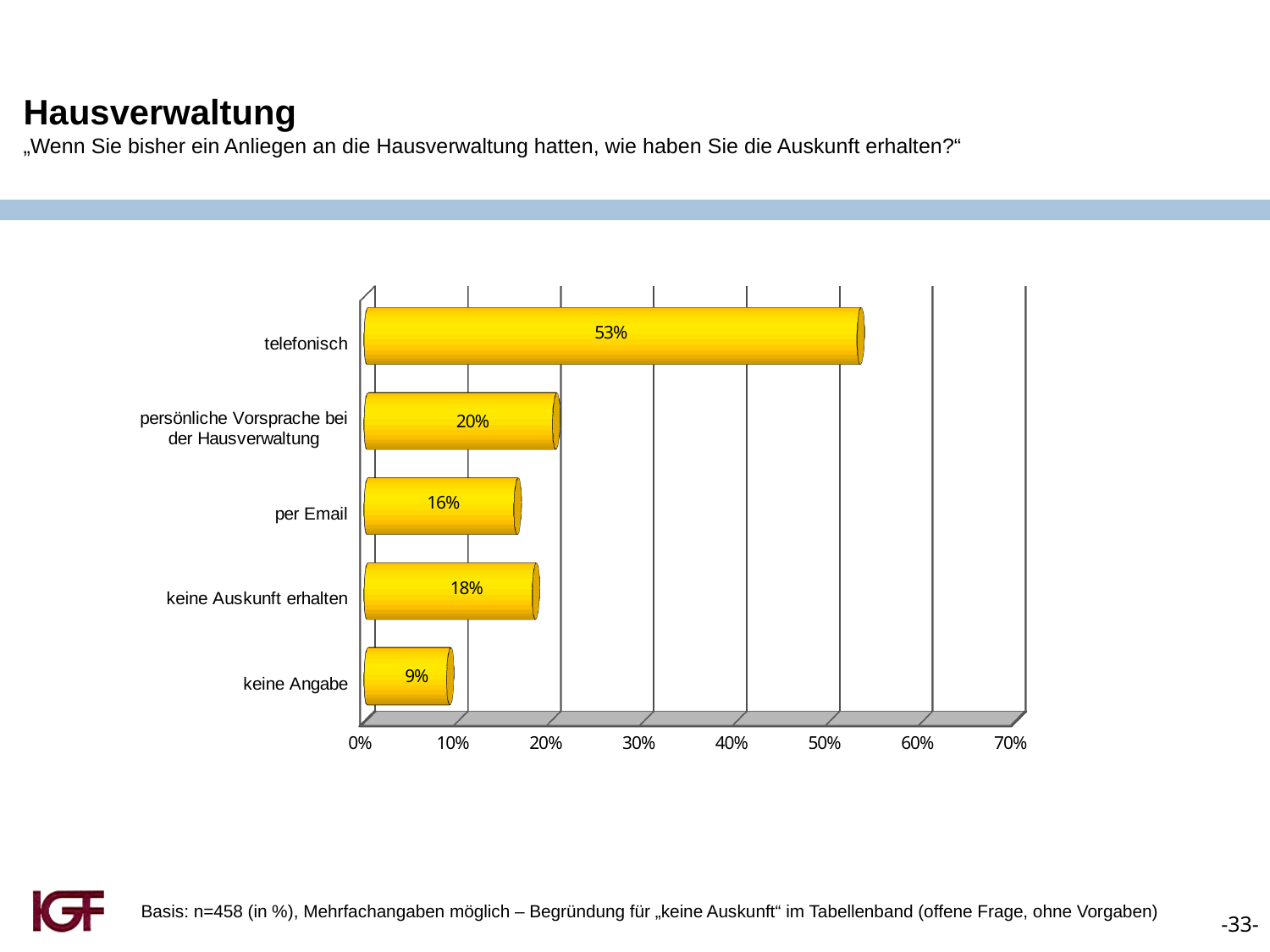
What is the value for "telefonisch"? 53% What is the value for "persönliche Vorsprache bei der Hausverwaltung"? 20% What is the value for "keine Angabe"? 9% What is the value for "per Email"? 16% Is the value for "telefonisch" greater or less than 50%? greater What is the value for "keine Auskunft erhalten"? 18% What is the difference between the values for "telefonisch" and "persönliche Vorsprache bei der Hausverwaltung"? 33% What kind of chart is shown on the slide? bar chart Which category has the lowest value? keine Angabe Which category has the highest value? telefonisch Which is larger, the value for "keine Auskunft erhalten" or the value for "per Email"? keine Auskunft erhalten How many categories are shown in the chart? 5